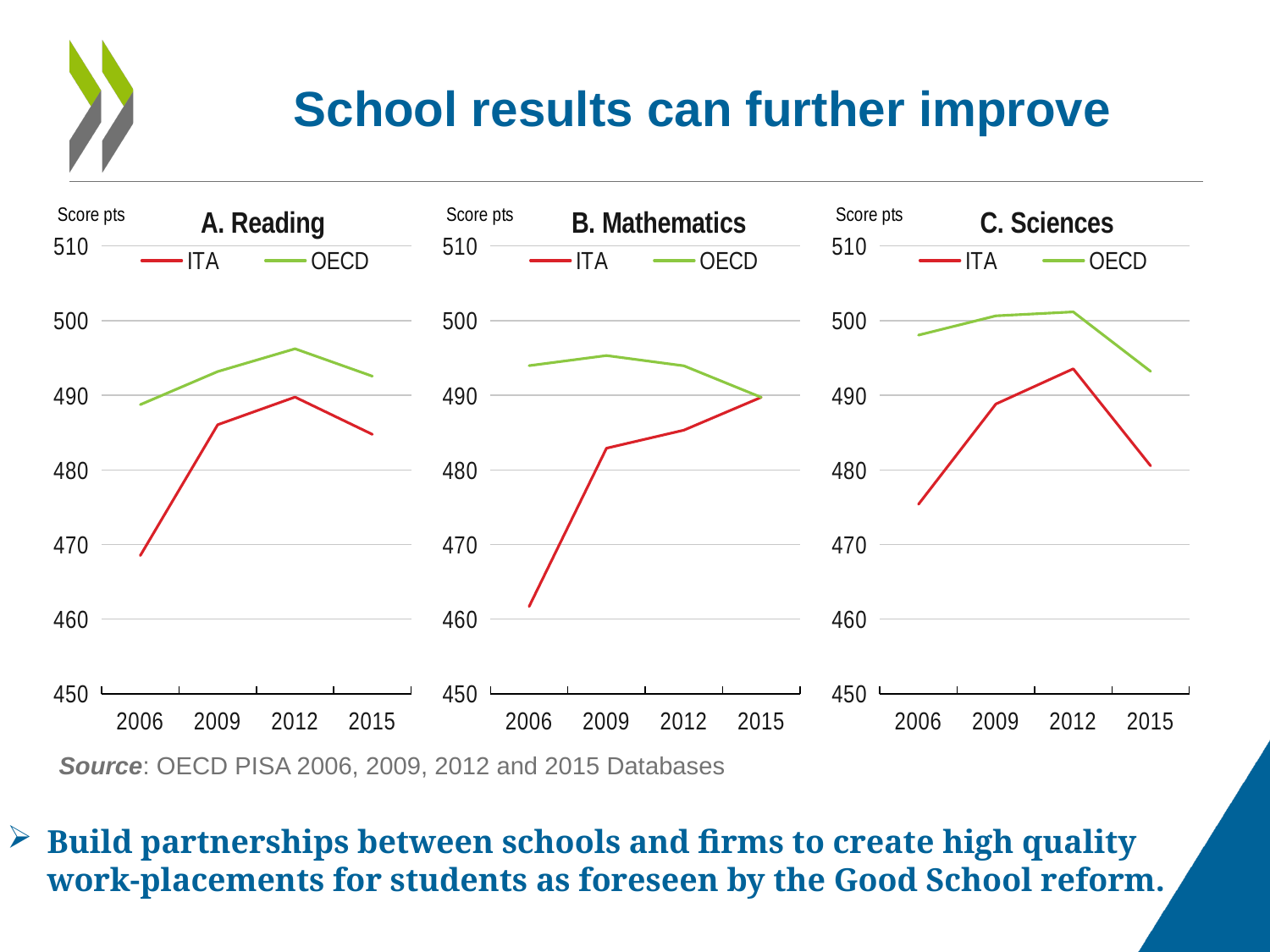
In "C. Sciences", is the ITA value for 2015 greater or less than 490? less In "C. Sciences", which series has the higher value in 2015, ITA or OECD? OECD In "B. Mathematics", is the ITA value for 2006 greater or less than 470? less What colour is the ITA line in the charts? red How many years are shown on the x axis of "C. Sciences"? 4 What kind of chart is "A. Reading"? line chart In "B. Mathematics", in which year is the ITA score lowest? 2006 In "A. Reading", is the ITA value for 2006 greater or less than 470? less In "A. Reading", does the OECD line rise or fall from 2012 to 2015? fall In "C. Sciences", in which year is the ITA score highest? 2012 In "B. Mathematics", does the ITA line rise or fall from 2006 to 2015? rise How many series does the legend of "B. Mathematics" list? 2